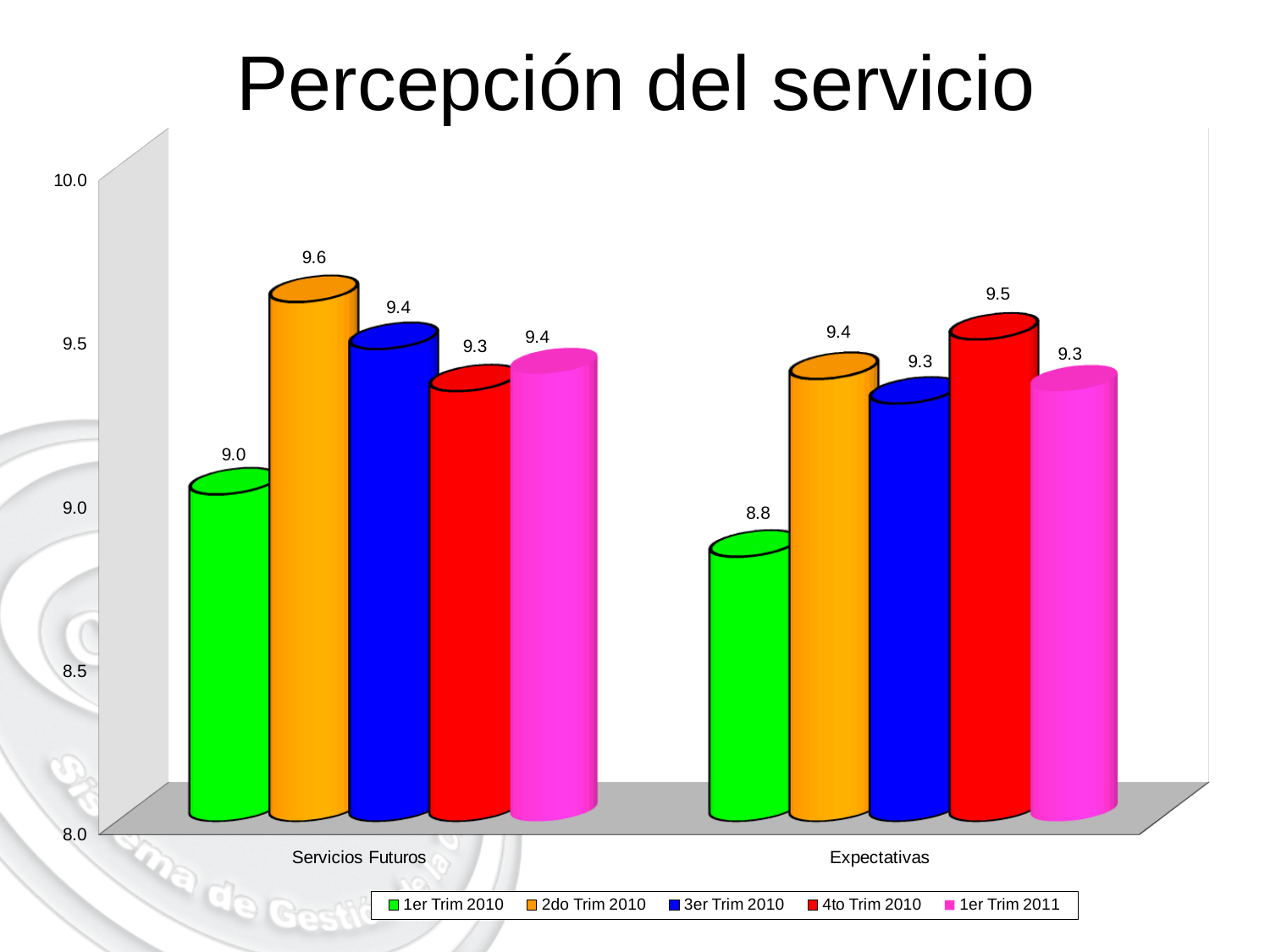
What is the value for 1er Trim 2010 in the Expectativas category? 8.8 What is the value for 4to Trim 2010 in the Expectativas category? 9.5 Which is larger: the 4to Trim 2010 value for Servicios Futuros or the 4to Trim 2010 value for Expectativas? Expectativas Is the value for 1er Trim 2010 in the Expectativas category greater or less than 9.0? less What kind of chart is shown on the slide? bar chart Which series has the highest value in the Servicios Futuros category? 2do Trim 2010 What is the title of the chart? Percepción del servicio How many categories are shown on the x axis? 2 What is the value for 2do Trim 2010 in the Servicios Futuros category? 9.6 How many series does the legend list? 5 What is the difference between the 2do Trim 2010 value and the 1er Trim 2010 value in the Servicios Futuros category? 0.6 Which series has the lowest value in the Expectativas category? 1er Trim 2010